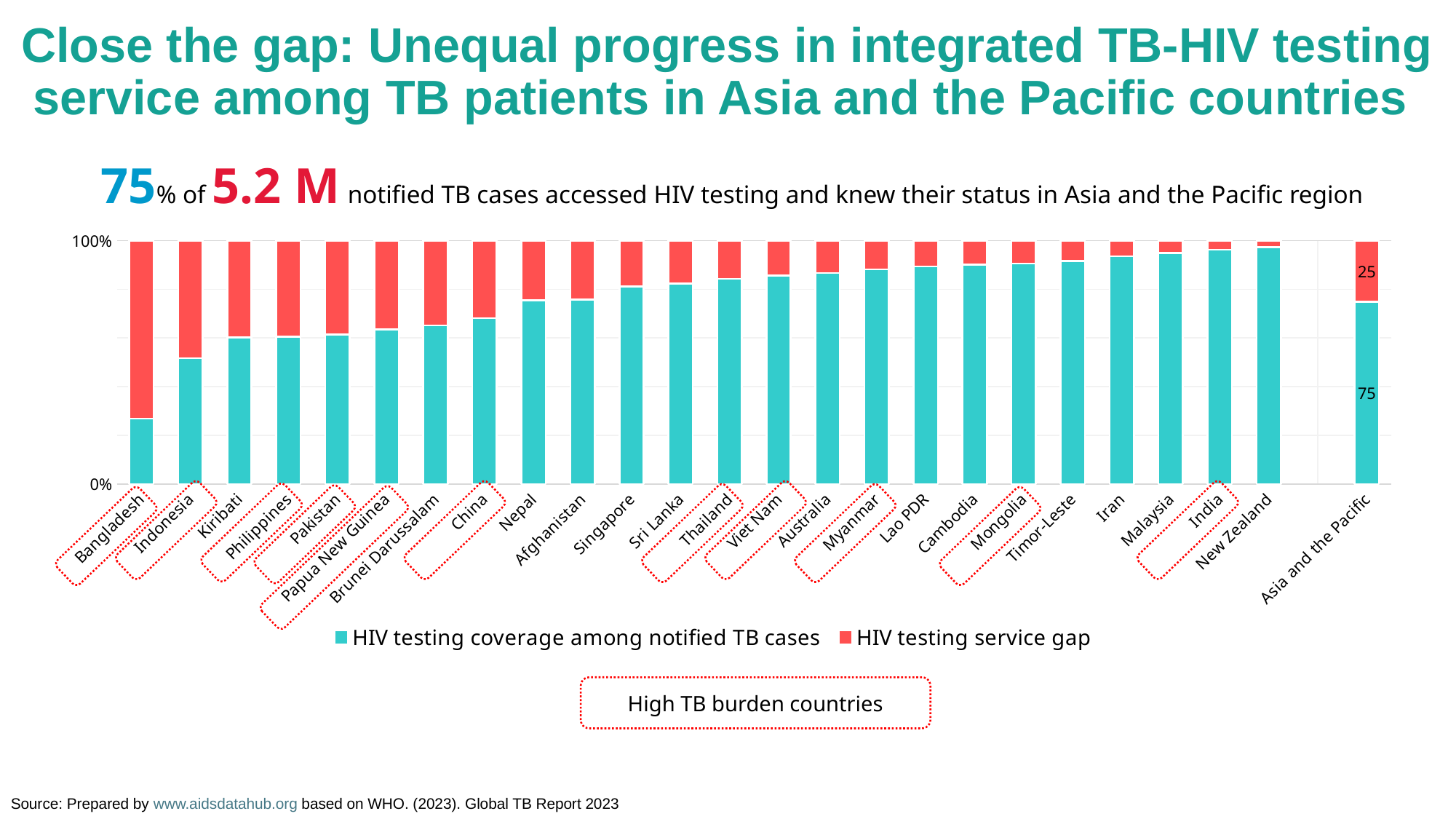
Does HIV testing coverage among notified TB cases rise or fall moving from Bangladesh to New Zealand along the x axis? Rise How many series does the legend list? 2 Which has higher HIV testing coverage among notified TB cases, Indonesia or Kiribati? Kiribati What is the HIV testing coverage among notified TB cases for Asia and the Pacific? 75 What is the difference between the HIV testing coverage and the HIV testing service gap for Asia and the Pacific? 50 What is the total of the Asia and the Pacific stacked bar? 100 How many bars are plotted on the chart? 25 What is the HIV testing service gap for Asia and the Pacific? 25 Which country has the largest HIV testing service gap? Bangladesh Which country has the lowest HIV testing coverage among notified TB cases? Bangladesh Which country has the highest HIV testing coverage among notified TB cases? New Zealand What kind of chart is shown on the slide? Stacked bar chart